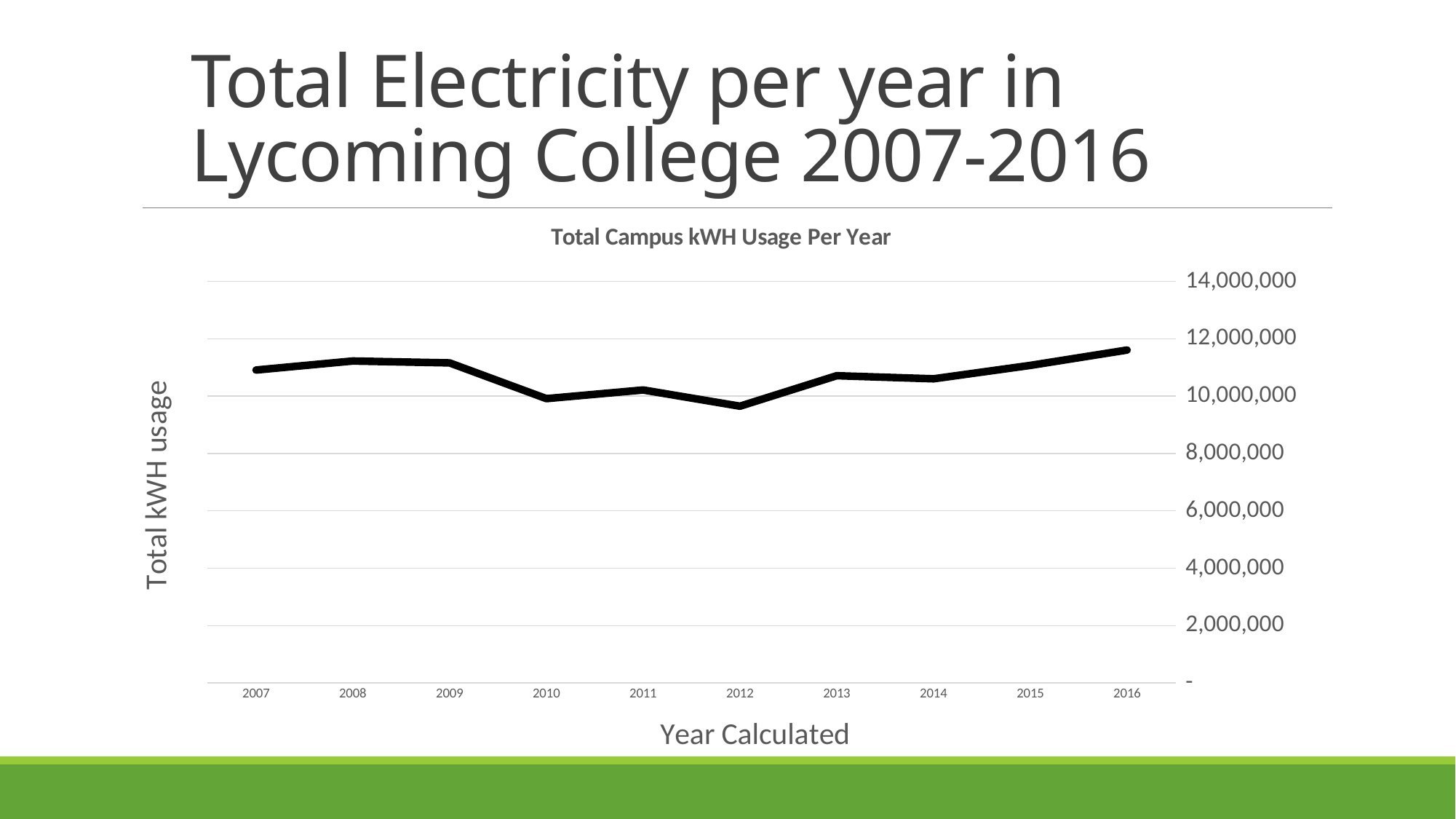
Which year has the larger kWH usage, 2009 or 2010? 2009 Does the kWH usage rise or fall from 2012 to 2016? rise Which year has the highest total campus kWH usage? 2016 Is the value for 2013 greater or less than 10,000,000? greater What kind of chart is shown on the slide? line chart Is the value for 2012 greater or less than 10,000,000? less What is the title of the chart? Total Campus kWH Usage Per Year Which year has the larger kWH usage, 2012 or 2013? 2013 Is the value for 2016 greater or less than 10,000,000? greater Which year has the lowest total campus kWH usage? 2012 How many years are plotted on the x axis? 10